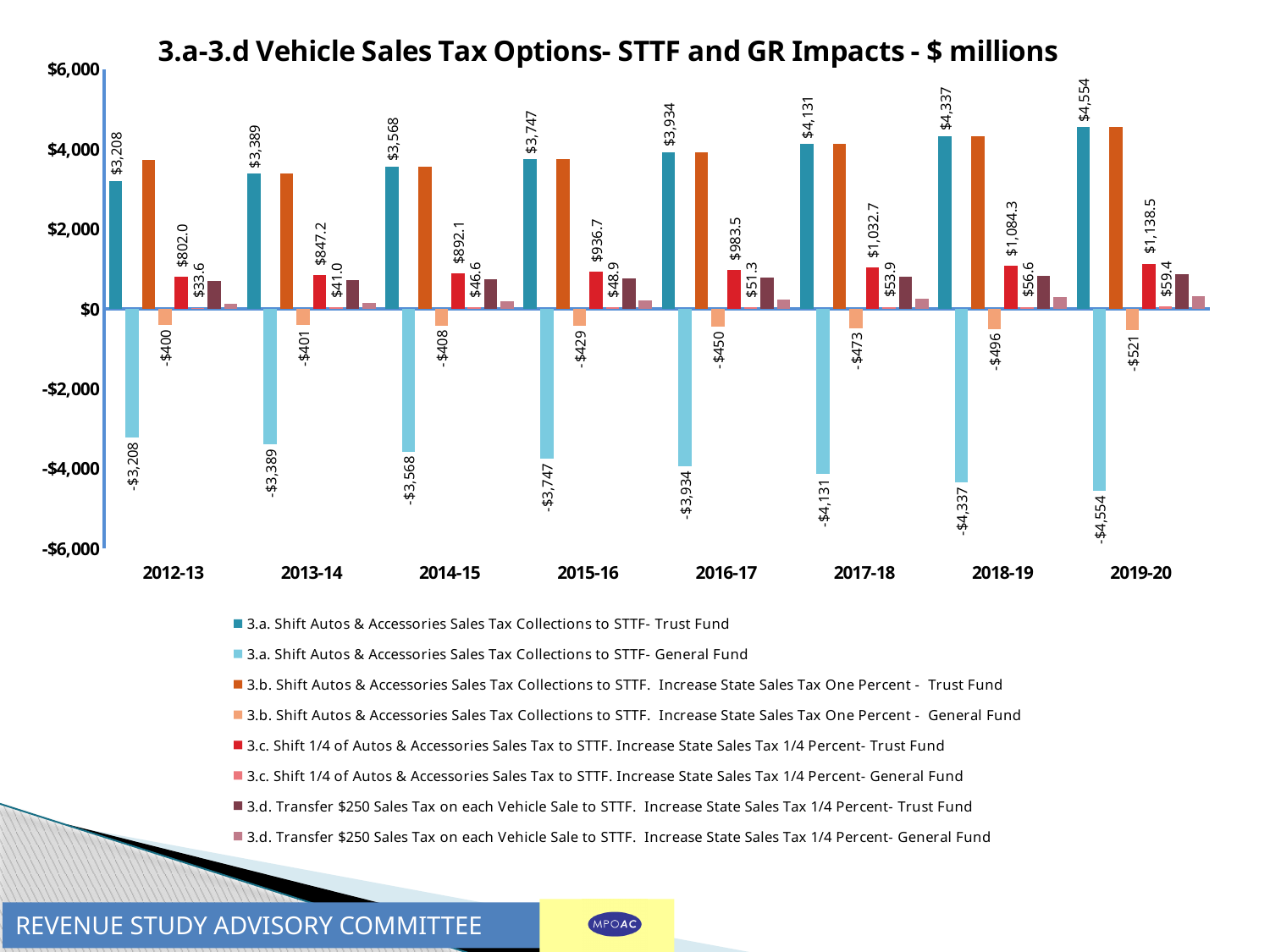
What is the value of the 3.b General Fund series for 2016-17? -$450 What is the value of the 3.c Trust Fund series for 2019-20? $1,138.5 What is the value of the 3.a Trust Fund series for 2012-13? $3,208 In which fiscal year is the 3.a Trust Fund value highest? 2019-20 For 2015-16, which is larger: the 3.a Trust Fund value or the 3.c Trust Fund value? 3.a Trust Fund What is the difference between the 3.c Trust Fund values for 2019-20 and 2012-13? $336.5 What is the value of the 3.c General Fund series for 2014-15? $46.6 Do the 3.a Trust Fund values rise or fall from 2012-13 to 2019-20? rise In which fiscal year is the 3.c Trust Fund value lowest? 2012-13 How many fiscal years are shown on the x axis? 8 Is the 3.b Trust Fund value for 2012-13 greater or less than $2,000? greater How many series does the legend list? 8